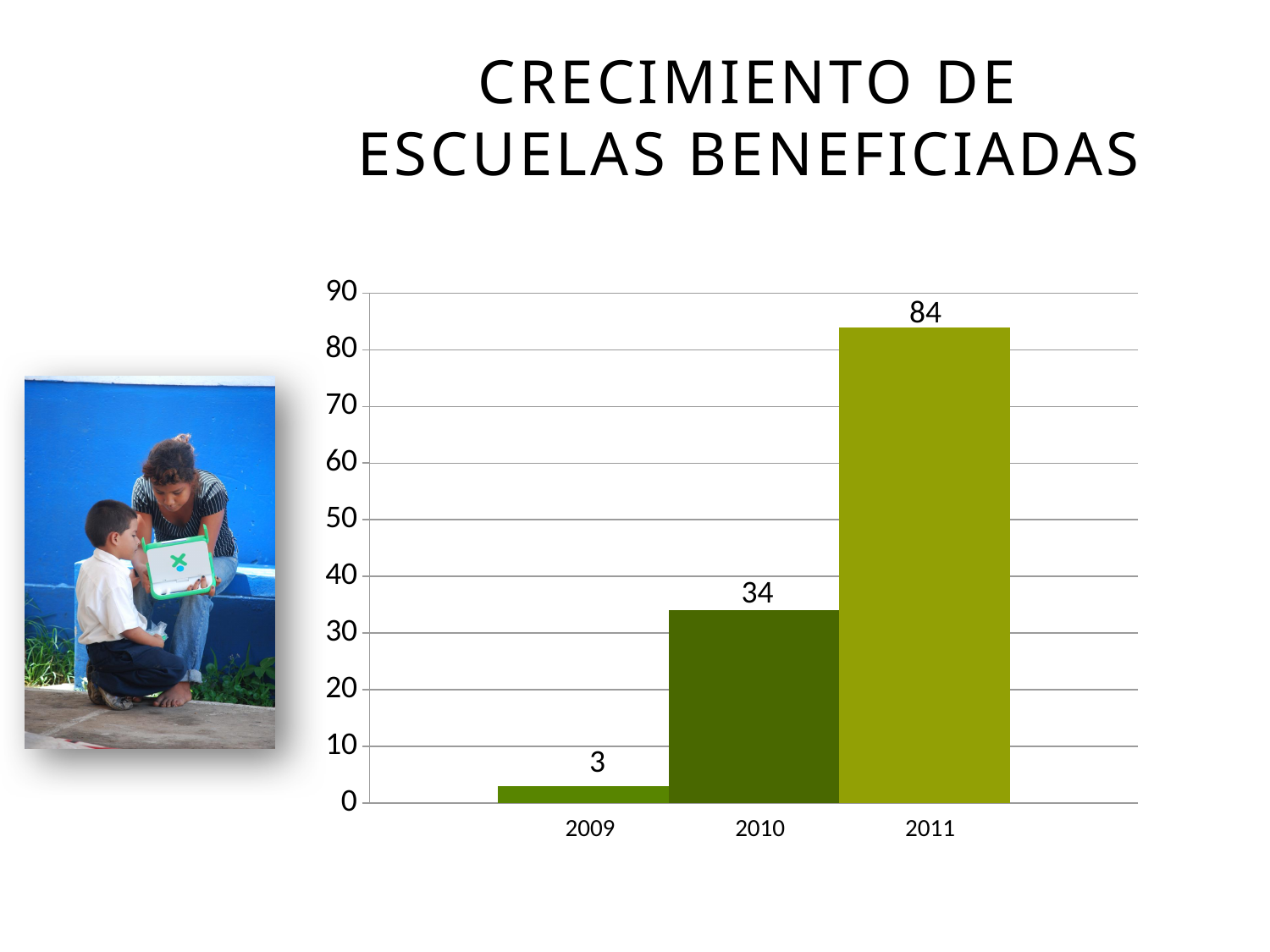
Is the value for 2011 greater or less than 80? greater What kind of chart is shown on the slide? bar chart What is the value for 2011? 84 What is the difference between the values for 2010 and 2009? 31 How many years are shown on the chart? 3 What is the difference between the values for 2011 and 2010? 50 Which year has the lowest value? 2009 Which year has the highest value? 2011 What is the value for 2010? 34 What is the value for 2009? 3 Which is larger, the value for 2010 or the value for 2009? 2010 Do the values rise or fall from 2009 to 2011? rise